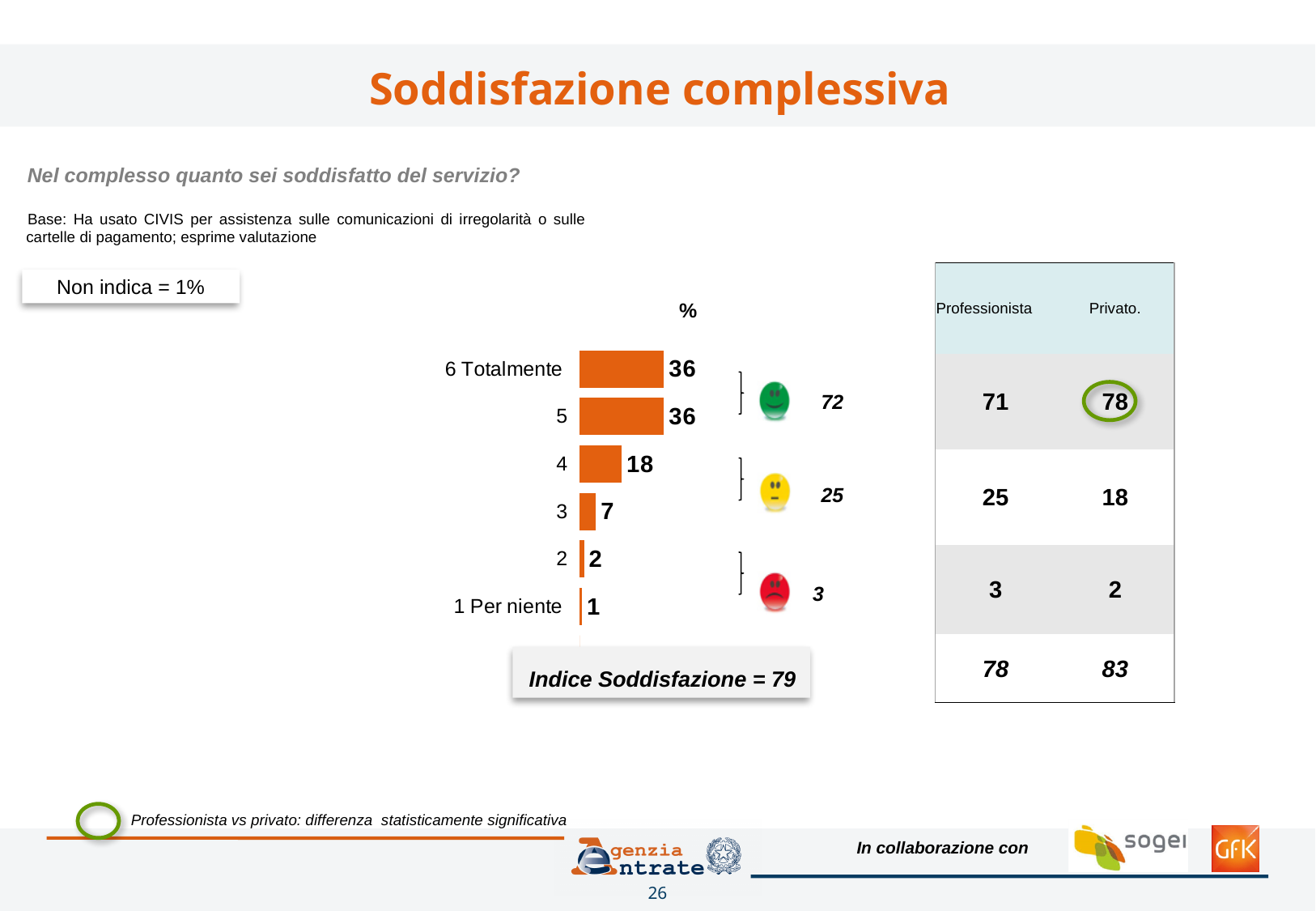
How many categories are shown in the bar chart? 6 What is the combined value shown for categories 2 and 1 (the red face group)? 3 What is the value for the category "4"? 18 What kind of chart is shown on the slide? bar chart Which category has the lowest value? 1 Per niente Which is larger, the value for category "4" or the value for category "2"? 4 What is the value for the category "1 Per niente"? 1 What is the difference between the values for category "4" and category "3"? 11 What is the combined value shown for categories 6 and 5 (the green face group)? 72 What is the Indice Soddisfazione shown below the chart? 79 What is the value for the category "6 Totalmente"? 36 What is the value for the category "3"? 7